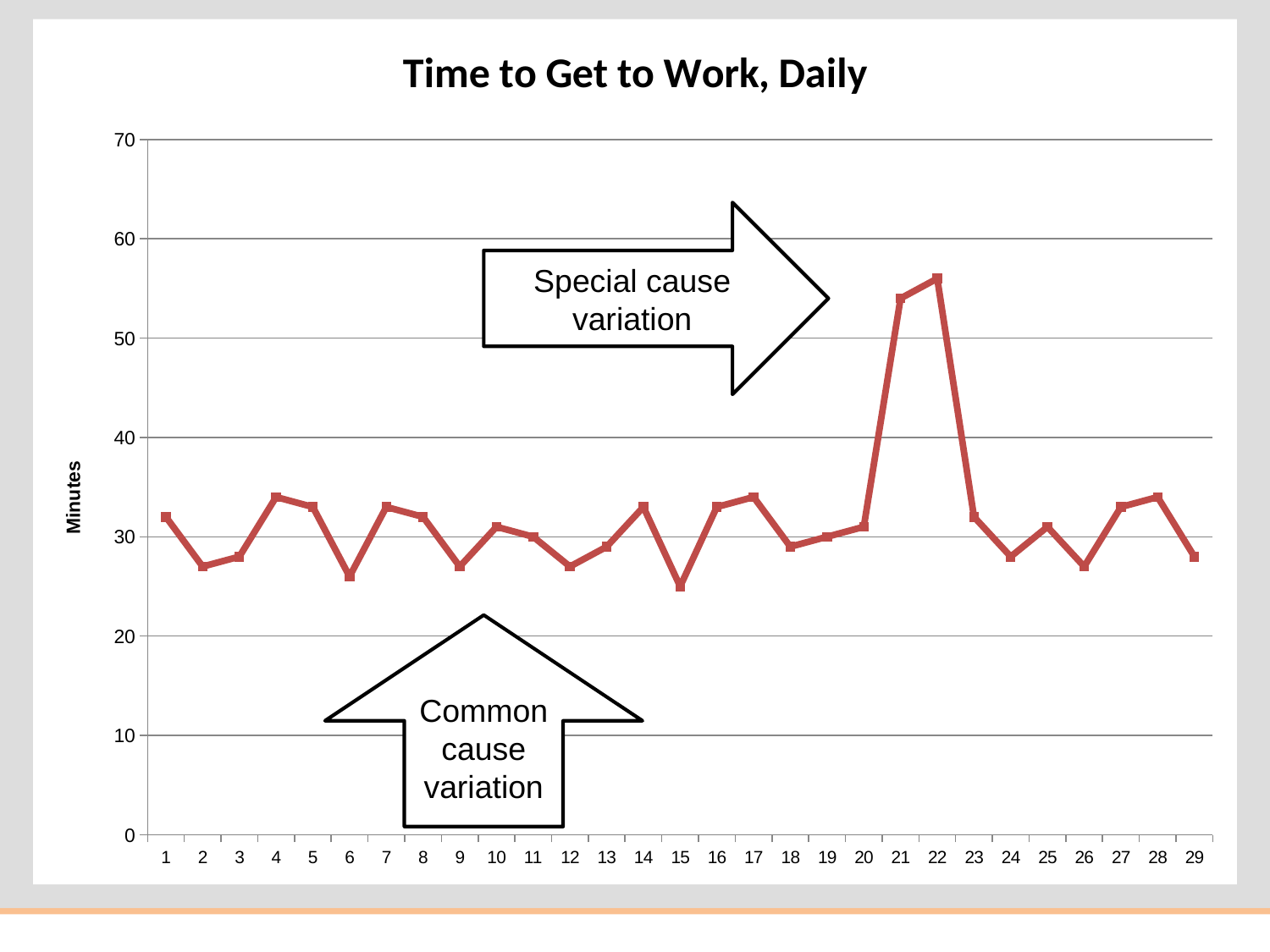
What is the label on the vertical axis of the chart? Minutes What is the title of the chart? Time to Get to Work, Daily Is the value for day 21 greater or less than 50? greater Is the value for day 4 greater or less than 30? greater How many days (data points) are plotted on the chart? 29 What kind of chart is shown on the slide? line chart On which day is the time to get to work highest? 22 Is the value for day 15 greater or less than 30? less Which day has the larger value, day 22 or day 1? 22 Which day has the larger value, day 4 or day 6? 4